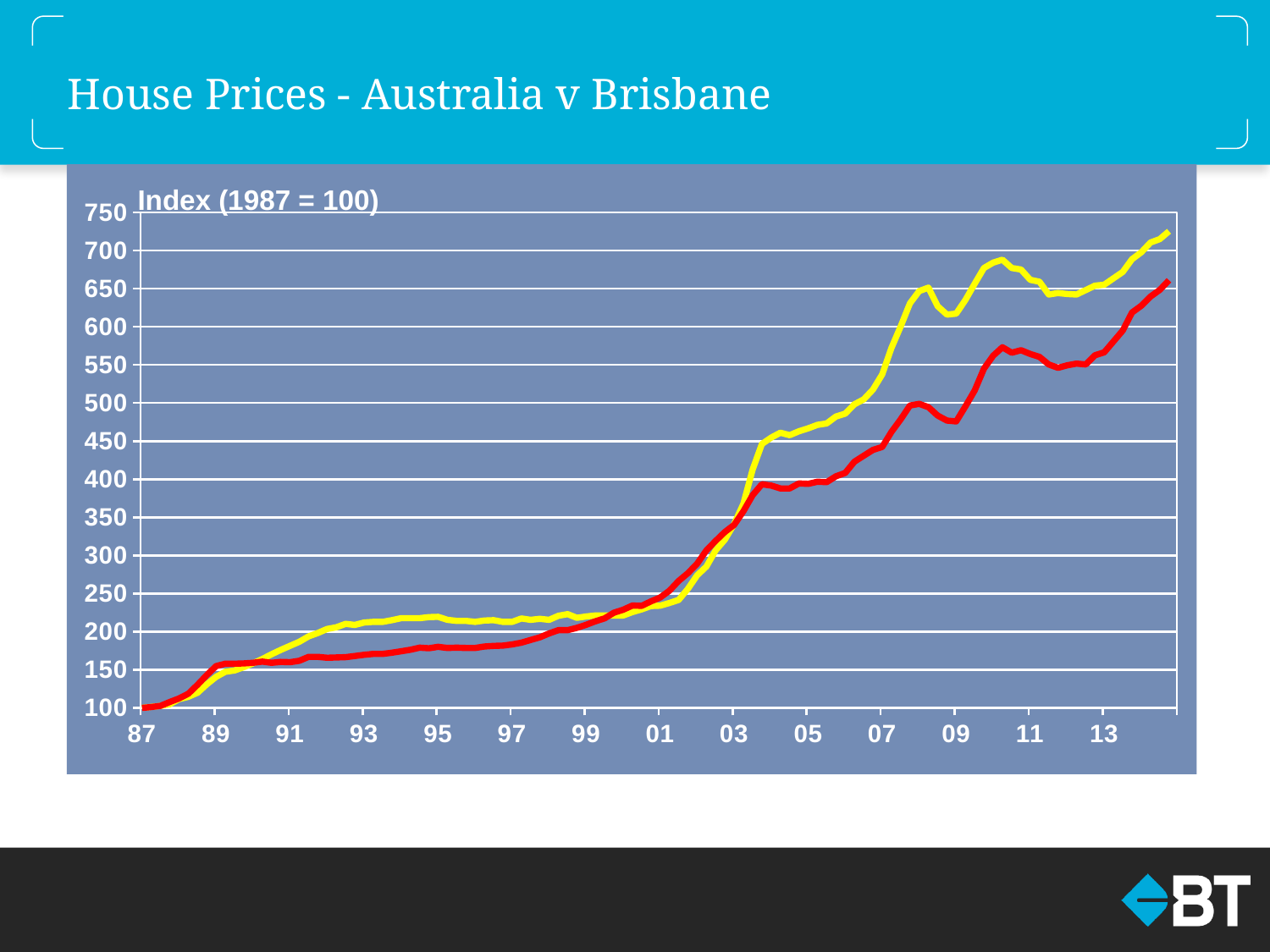
Is the value of the red line at 11 greater or less than 500? greater Is the value of the yellow line at 05 greater or less than 400? greater Is the value of the red line at 93 greater or less than 200? less How many lines are plotted on the chart? 2 Do the values of the lines generally rise or fall from 87 to the end of the chart? rise What label is shown at the top of the vertical axis of the chart? Index (1987 = 100) At 11, which line has the higher value, the yellow line or the red line? the yellow line What is the title of the chart on the slide? House Prices - Australia v Brisbane What is the value of both lines at 87? 100 What kind of chart is shown on the slide? line chart